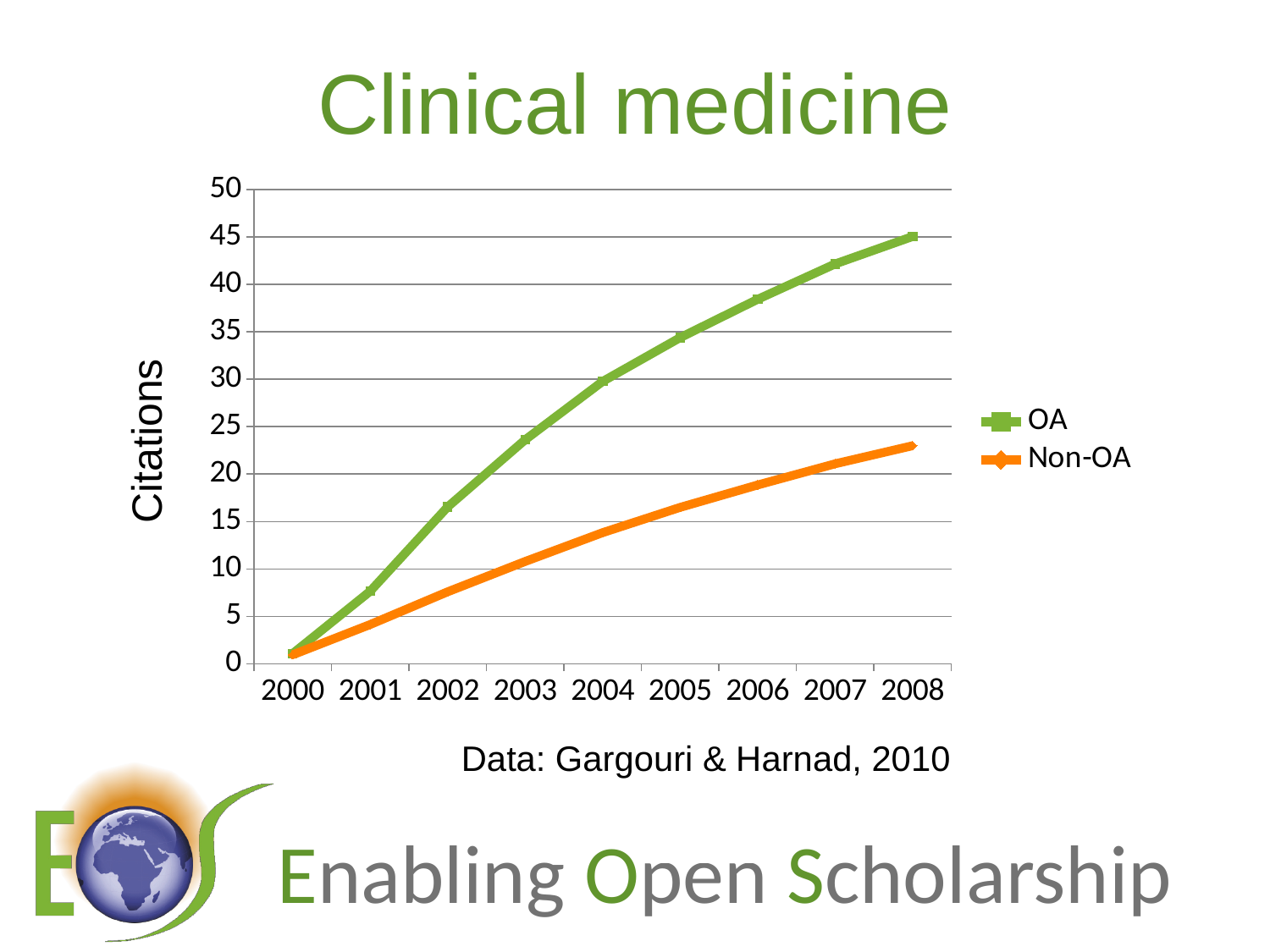
Do the Non-OA citations rise or fall from 2000 to 2008? rise How many years are shown along the x axis? 9 In which year does the OA series reach its highest value? 2008 What is the label on the y axis? Citations Do the OA citations rise or fall from 2000 to 2008? rise Is the Non-OA value for 2004 greater or less than 20? less How many series does the legend list? 2 Is the OA value for 2008 greater or less than 40? greater Is the Non-OA value for 2008 greater or less than 25? less What kind of chart is shown on the slide? line chart In 2008, which series has more citations, OA or Non-OA? OA